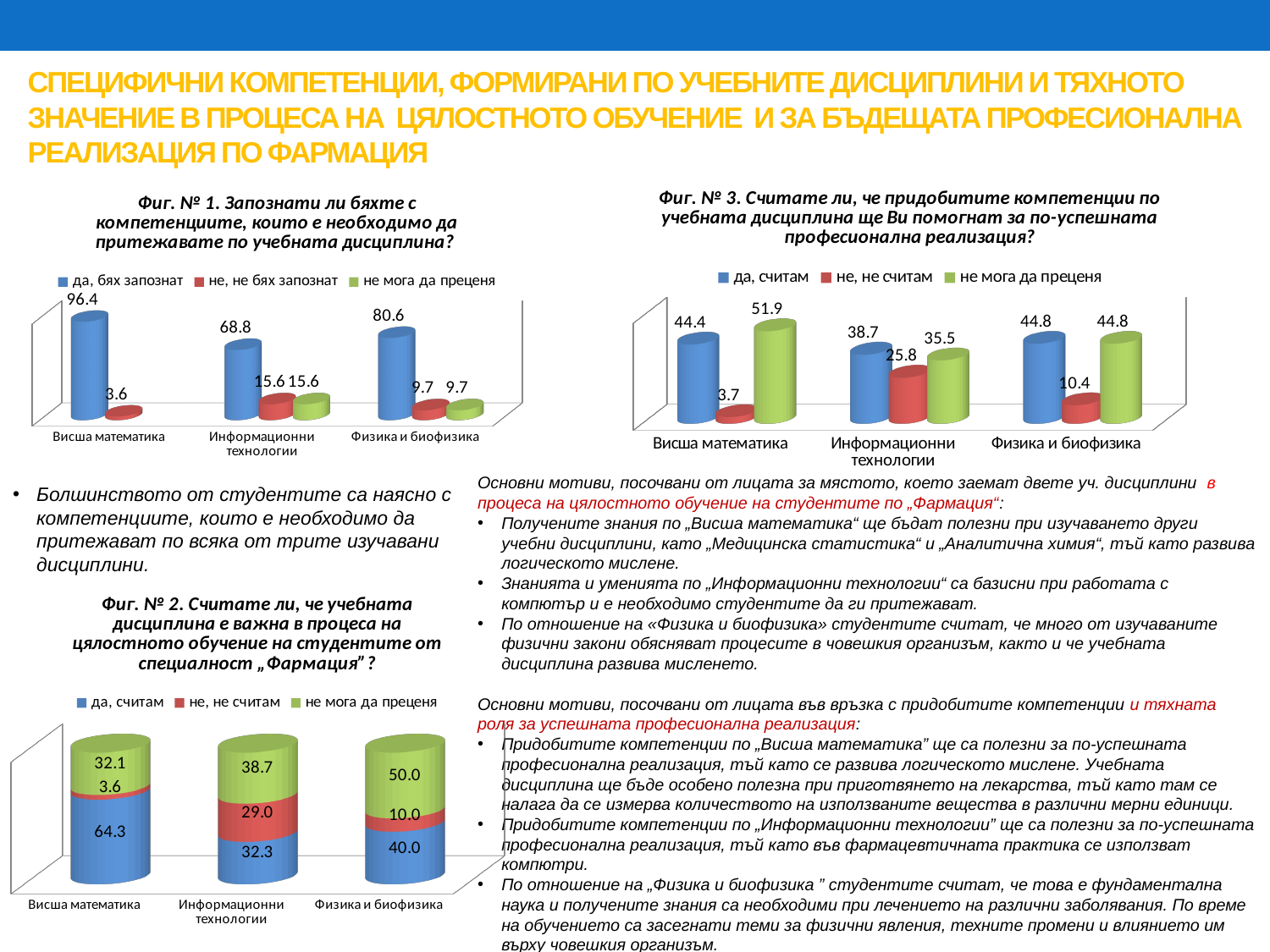
In the chart titled "Фиг. № 2", what is the value of "не, не считам" for "Информационни технологии"? 29.0 In the chart titled "Фиг. № 3", which is larger for "Информационни технологии": "да, считам" or "не мога да преценя"? да, считам In the chart titled "Фиг. № 3", how many categories are shown on the x axis? 3 In the chart titled "Фиг. № 1", what is the difference between the "да, бях запознат" values for "Висша математика" and "Физика и биофизика"? 15.8 In the chart titled "Фиг. № 2", which category has the highest value for "не мога да преценя"? Физика и биофизика In the chart titled "Фиг. № 1", what is the value of "да, бях запознат" for "Висша математика"? 96.4 What kind of chart is "Фиг. № 2"? Stacked bar chart In the chart titled "Фиг. № 3", what is the difference between "не, не считам" for "Информационни технологии" and for "Висша математика"? 22.1 In the chart titled "Фиг. № 1", which category has the lowest value for "да, бях запознат"? Информационни технологии In the chart titled "Фиг. № 1", how many series does the legend list? 3 In the chart titled "Фиг. № 2", what is the total of the stacked bar for "Висша математика"? 100.0 In the chart titled "Фиг. № 3", what is the value of "не мога да преценя" for "Висша математика"? 51.9